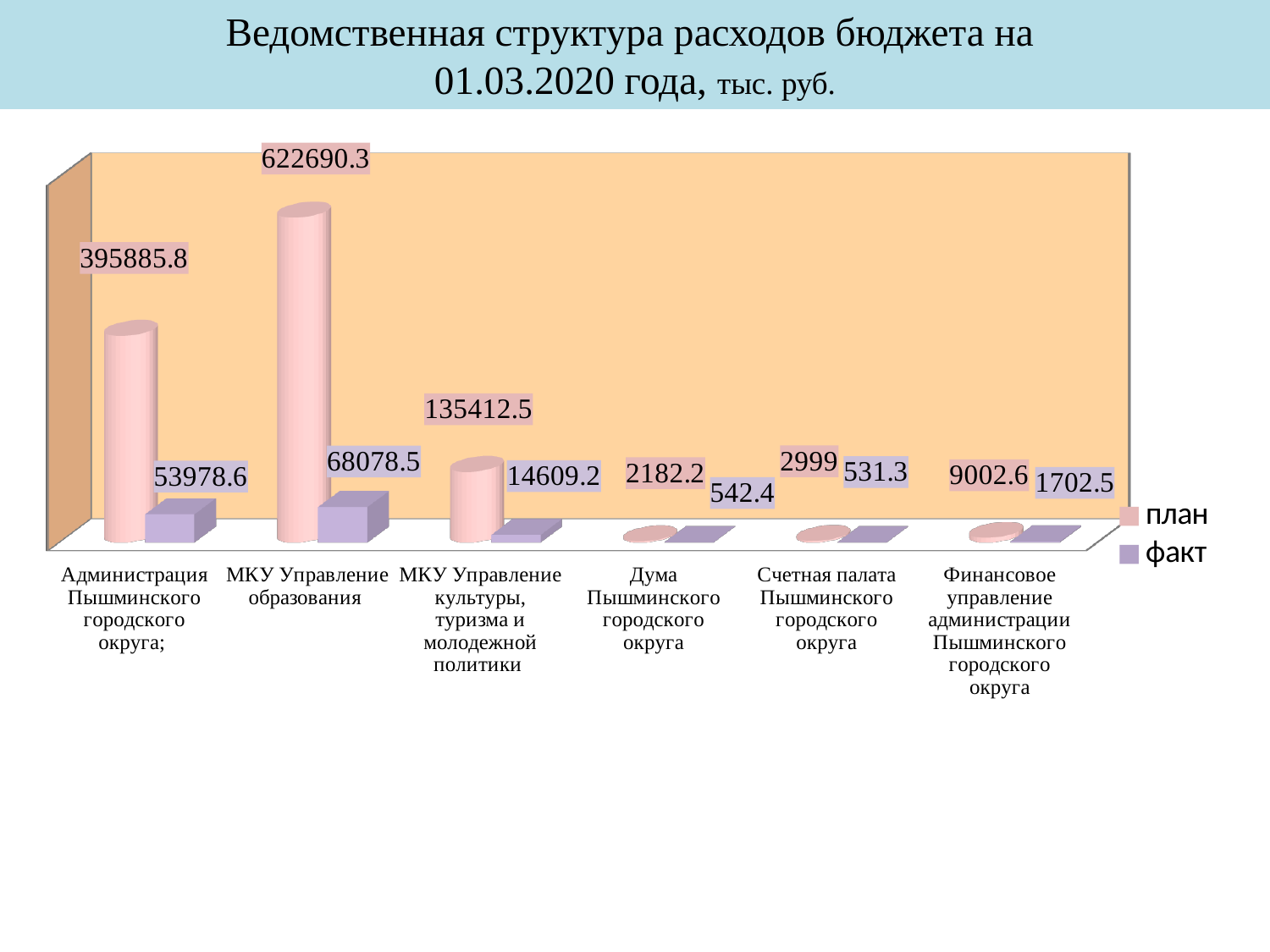
What kind of chart is shown on the slide? Bar chart What is the план value for МКУ Управление образования? 622690.3 How many categories are shown on the x axis? 6 What is the difference between the план values for Счетная палата Пышминского городского округа and Дума Пышминского городского округа? 816.8 Which category has the highest план value? МКУ Управление образования Which is larger: the факт value for Дума Пышминского городского округа or the факт value for Финансовое управление администрации Пышминского городского округа? Финансовое управление администрации Пышминского городского округа What is the план value for Счетная палата Пышминского городского округа? 2999 What is the факт value for Администрация Пышминского городского округа? 53978.6 Which category has the lowest факт value? Счетная палата Пышминского городского округа What is the факт value for Финансовое управление администрации Пышминского городского округа? 1702.5 How many series does the legend list? 2 What is the difference between the план and факт values for МКУ Управление образования? 554611.8